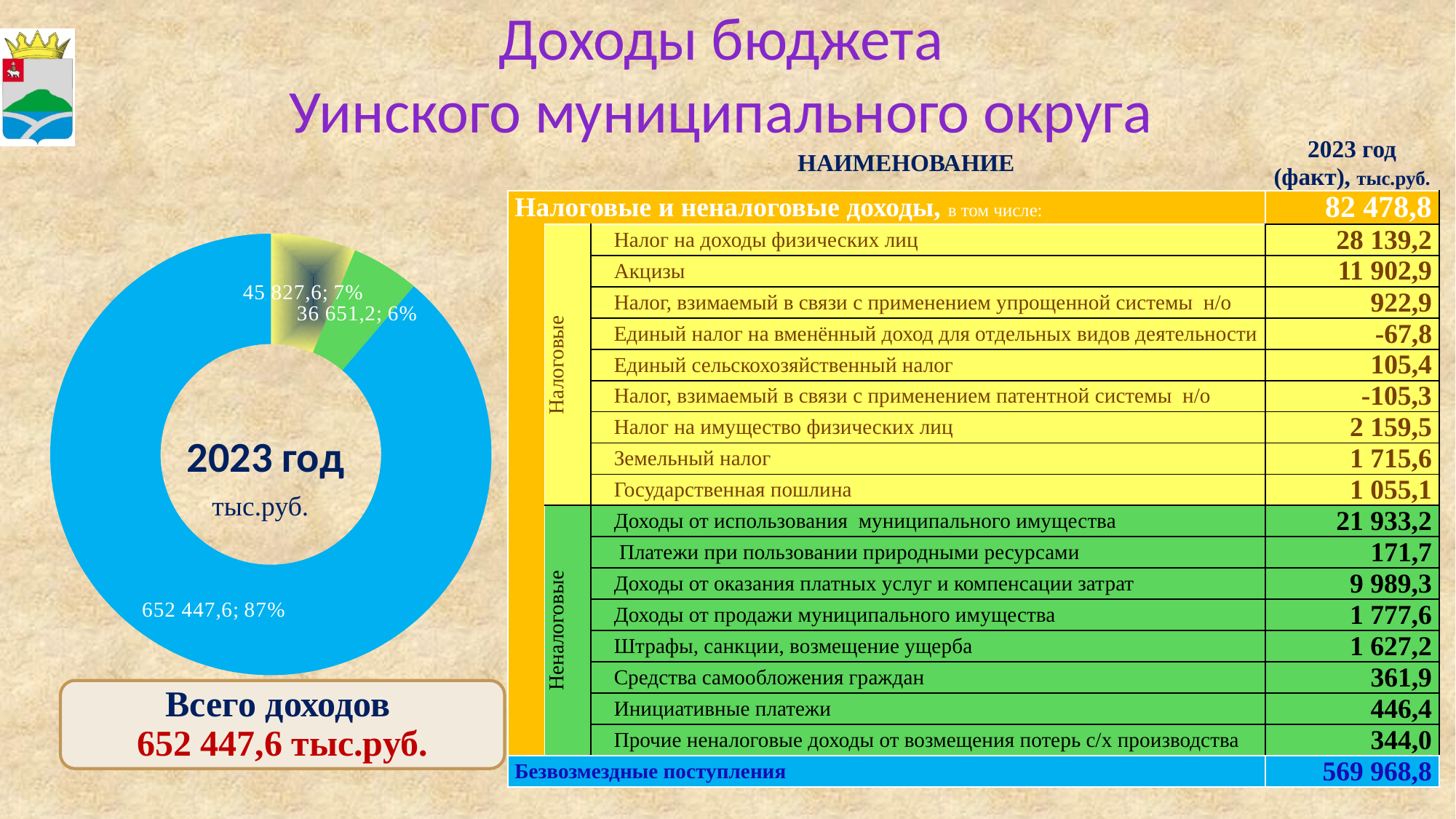
What share of the donut chart does the yellow slice represent? 7% What share of the donut chart does the blue slice represent? 87% How many slices does the donut chart have? 3 What is the difference between the values printed on the yellow and green slices of the donut chart? 9 176,4 Which slice of the donut chart has the largest share? The blue slice (87%) What value is printed on the green slice of the donut chart? 36 651,2 Which slice of the donut chart has the smallest share? The green slice (6%) What value is printed on the yellow slice of the donut chart? 45 827,6 What text is shown in the centre of the donut chart? 2023 год тыс.руб. What value is printed on the largest (blue) slice of the donut chart? 652 447,6 What share of the donut chart does the green slice represent? 6% What kind of chart is shown on the left of the slide? Pie (donut) chart